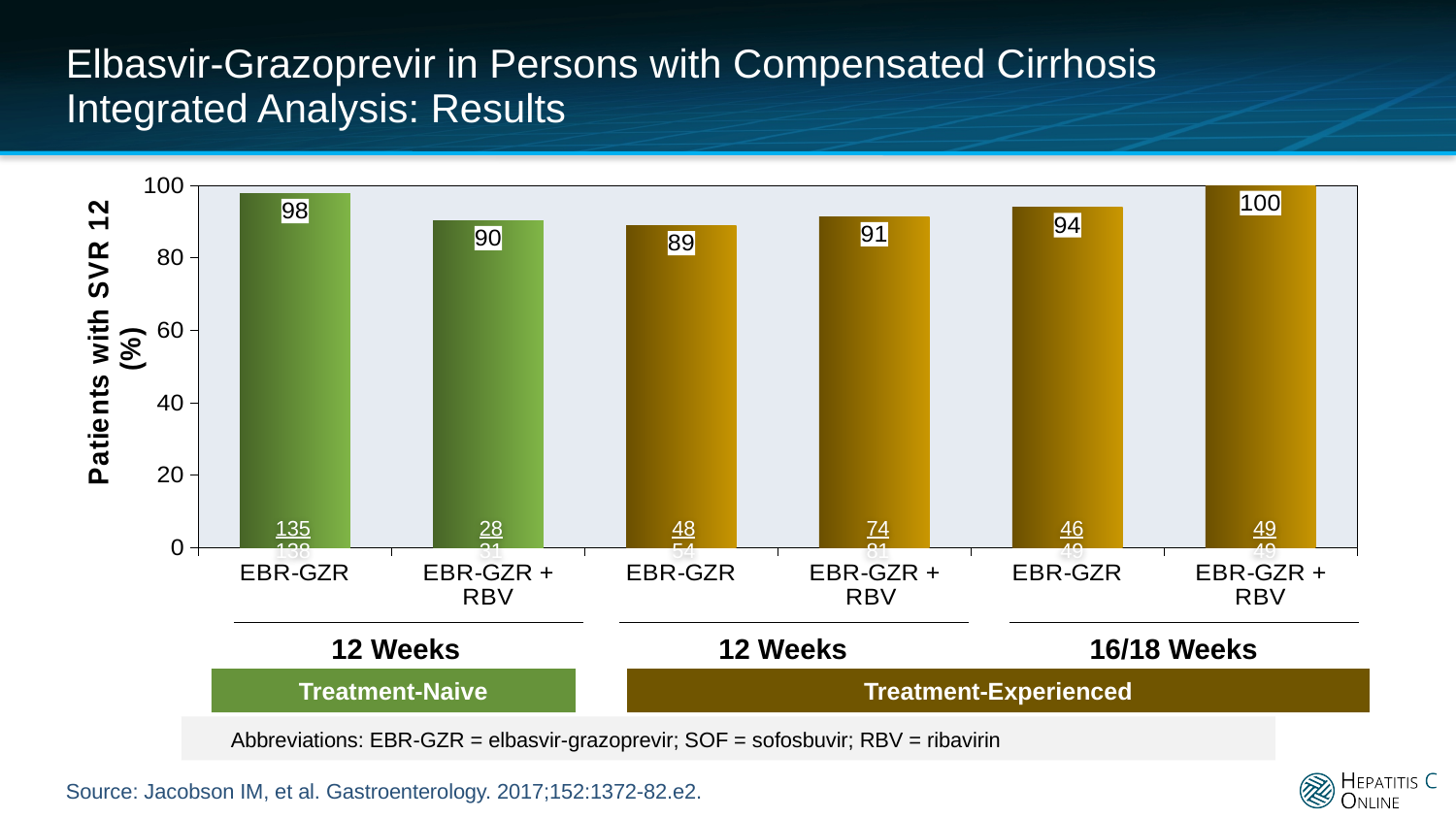
What type of chart is shown on the slide? Bar chart What is the numerator shown at the base of the EBR-GZR bar in the Treatment-Naive 12-week group? 135 Which bar has the lowest SVR 12 rate? EBR-GZR, 12 Weeks, Treatment-Experienced What is the SVR 12 rate for EBR-GZR for 12 weeks in the Treatment-Experienced group? 89 What is the difference in SVR 12 rate between EBR-GZR and EBR-GZR + RBV in the Treatment-Naive 12-week group? 8 What is the SVR 12 rate for EBR-GZR + RBV for 12 weeks in the Treatment-Naive group? 90 Which bar has the highest SVR 12 rate? EBR-GZR + RBV, 16/18 Weeks, Treatment-Experienced How many bars are shown in the chart? 6 In the Treatment-Experienced 12-week group, which has the higher SVR 12 rate: EBR-GZR or EBR-GZR + RBV? EBR-GZR + RBV What is the SVR 12 rate for EBR-GZR + RBV for 16/18 weeks in the Treatment-Experienced group? 100 What is the label of the y-axis? Patients with SVR 12 (%) What is the SVR 12 rate for EBR-GZR for 12 weeks in the Treatment-Naive group? 98